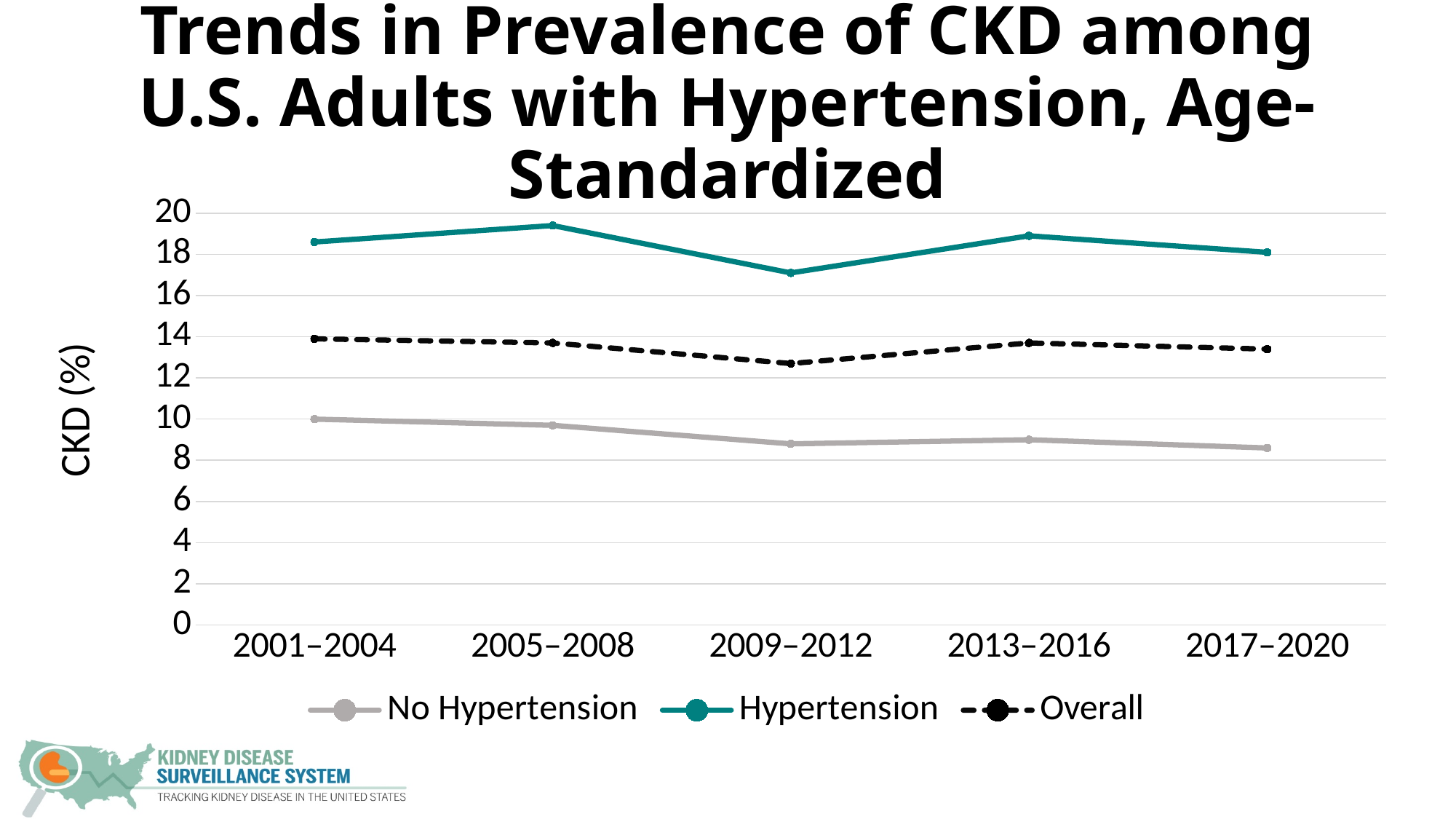
What kind of chart is shown on the slide? Line chart In which period is the Hypertension line at its highest? 2005–2008 Does the No Hypertension line generally rise or fall from 2001–2004 to 2017–2020? fall In which period is the Overall line at its lowest? 2009–2012 Is the Overall value for 2009–2012 greater or less than 12? greater How many series does the legend list? 3 Which series has the higher value in 2017–2020, Hypertension or No Hypertension? Hypertension Is the No Hypertension value for 2009–2012 greater or less than 10? less In which period is the Hypertension line at its lowest? 2009–2012 Is the Hypertension value for 2005–2008 greater or less than 18? greater How many time periods are shown on the x axis? 5